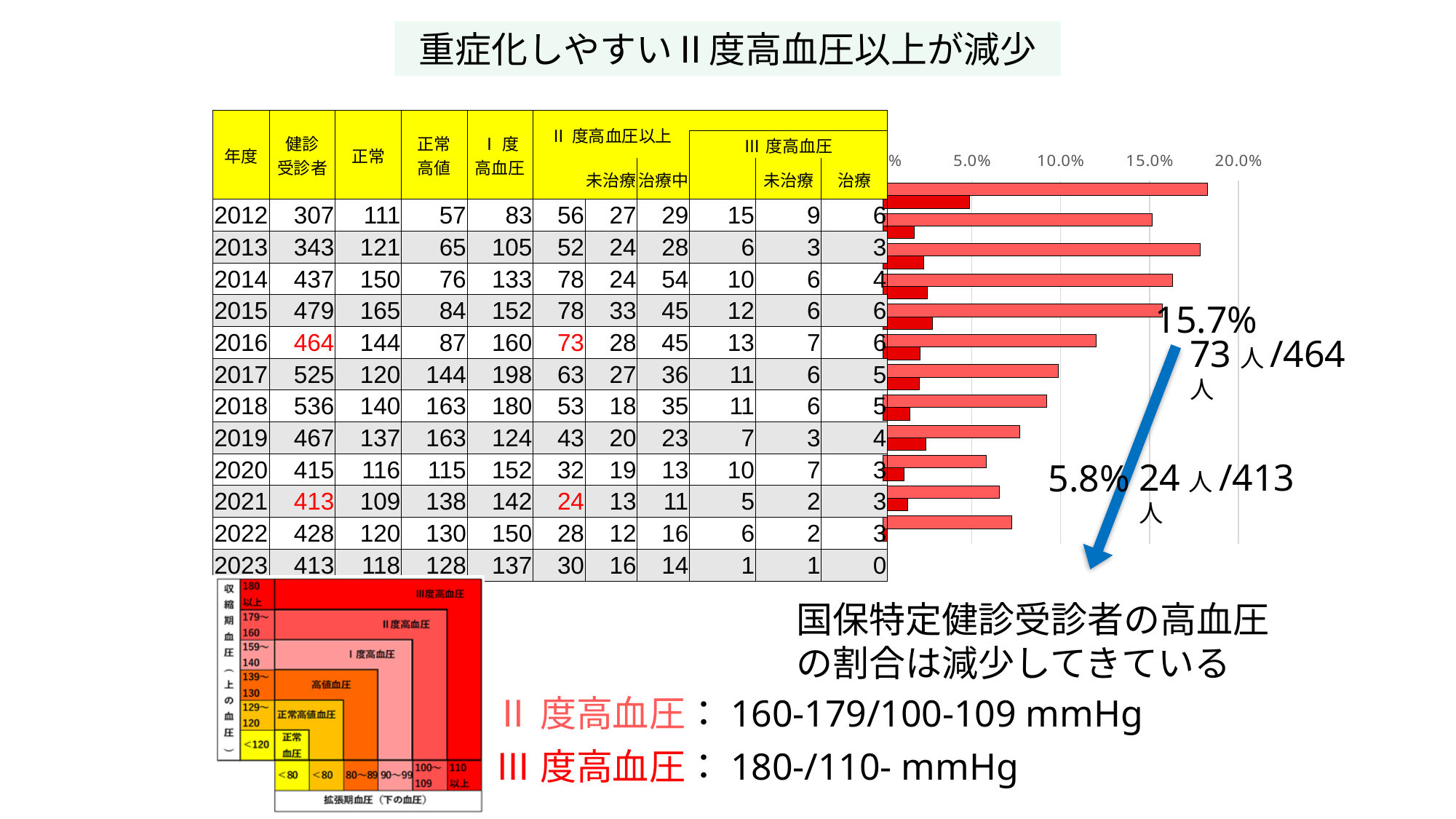
Do the light-red bars generally get shorter or longer going from the top of the chart to the bottom? shorter What is the highest percentage tick shown on the chart's horizontal axis? 20.0% Is the value of the topmost light-red bar greater or less than 15.0%? greater What is the difference between the two annotated percentages, 15.7% and 5.8%? 9.9% What kind of chart is shown on the right side of the slide? bar chart Which is larger, the topmost light-red bar or the bottommost light-red bar? the topmost light-red bar How many different bar colours are used in the chart? 2 Is the value of the bottommost light-red bar greater or less than 5.0%? greater What percentage is annotated next to the chart for 73人/464人? 15.7% What percentage is annotated next to the chart for 24人/413人? 5.8% Is the value of the bottommost light-red bar greater or less than 10.0%? less